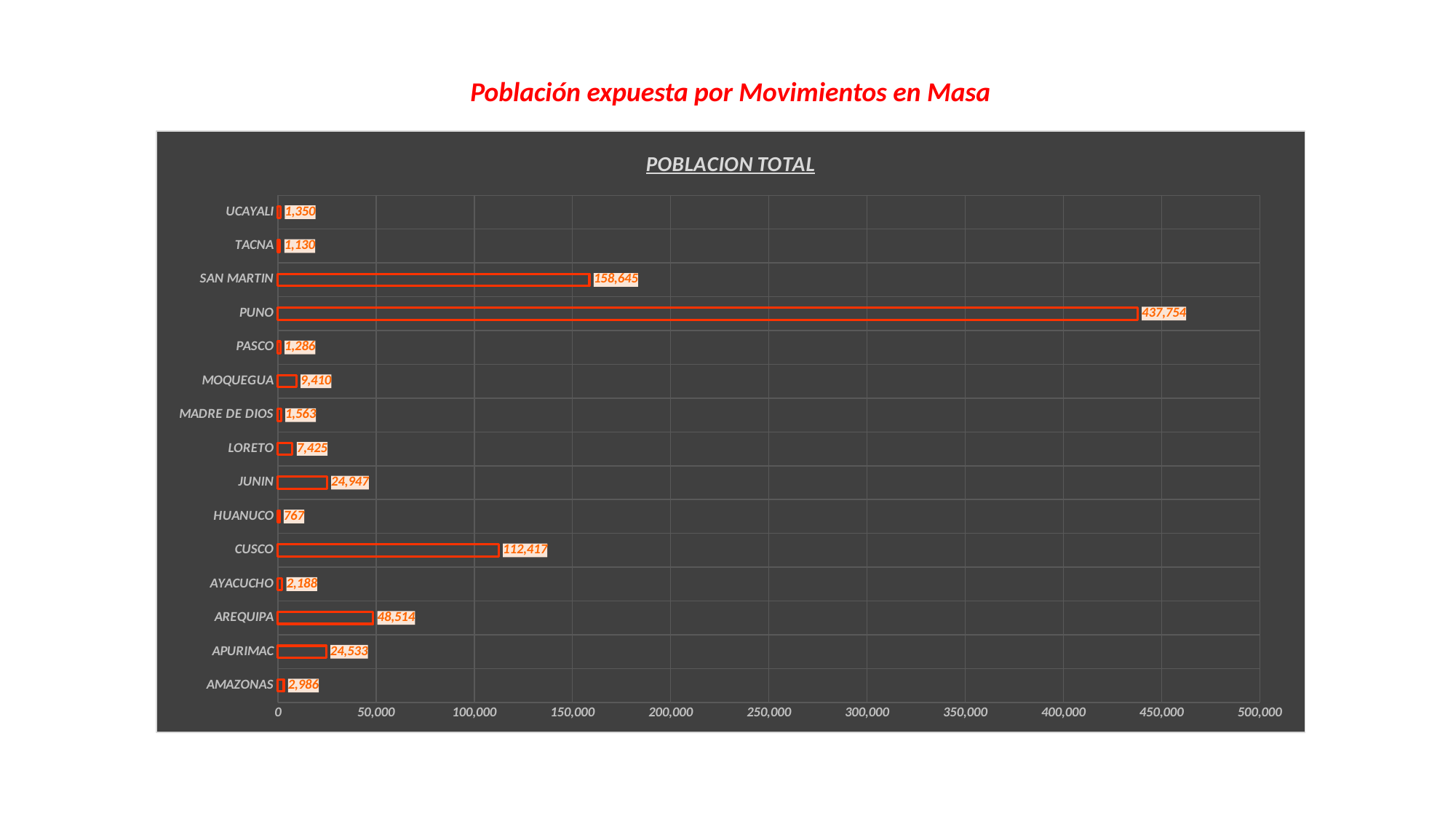
What is the value for CUSCO? 112,417 What is the value for HUANUCO? 767 What is the difference between the values for CUSCO and AREQUIPA? 63,903 What is the value for SAN MARTIN? 158,645 Which category has the highest value? PUNO Which is larger, the value for AREQUIPA or the value for MOQUEGUA? AREQUIPA What is the value for PUNO? 437,754 How many categories are shown on the chart? 15 What is the difference between the values for PUNO and SAN MARTIN? 279,109 Is the value for PUNO greater or less than 400,000? greater Which category has the lowest value? HUANUCO What kind of chart is shown on the slide? bar chart